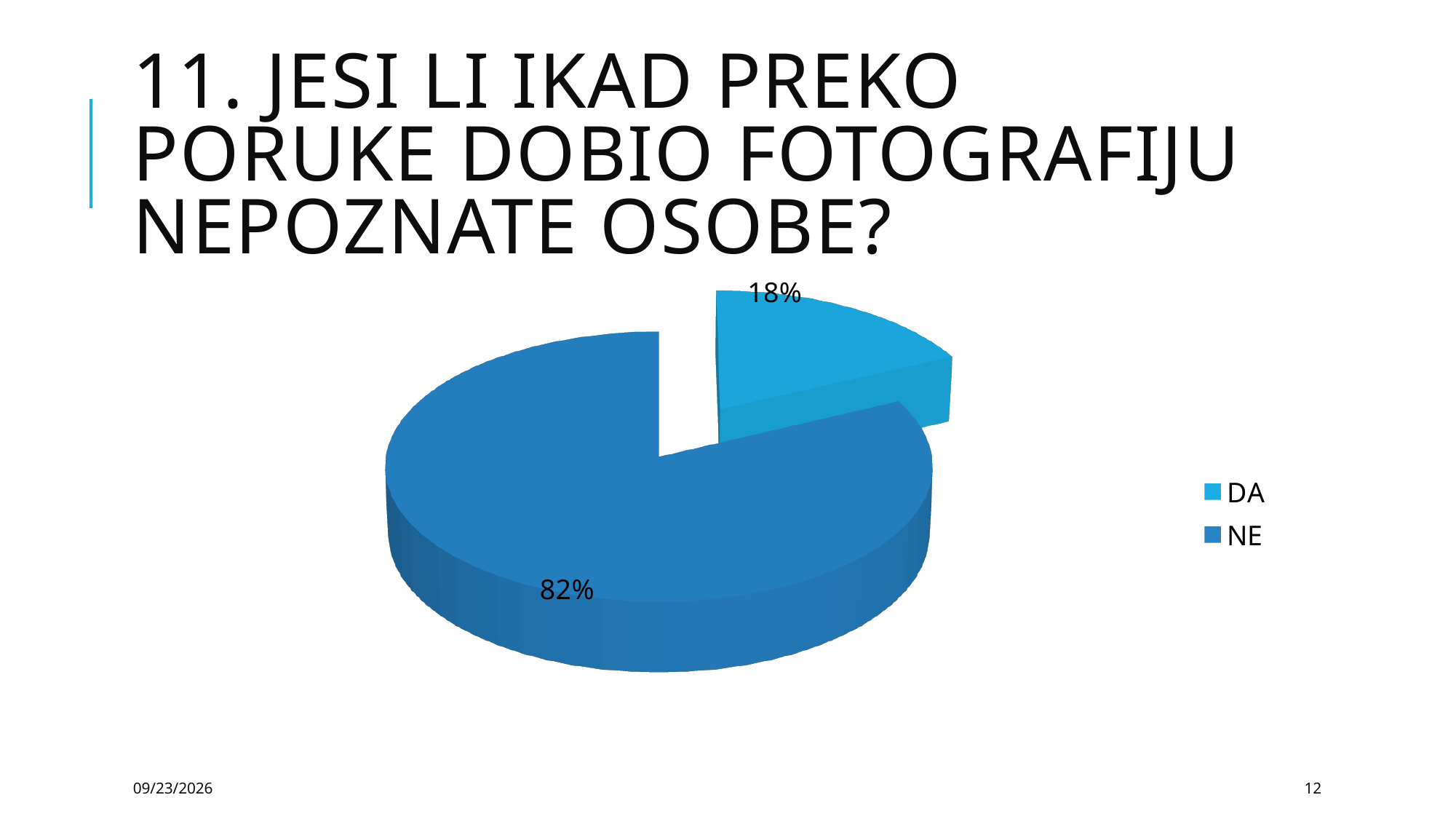
What share of the pie does the DA slice represent? 18% How many slices does the pie chart have? 2 What kind of chart is shown on the slide? pie chart Which slice is larger, DA or NE? NE Which answer has the smallest share of the pie? DA Is the share for NE greater or less than 50%? greater What is the difference in percentage points between the NE and DA slices? 64 What percentage of respondents answered NE? 82% Which legend entry is shown in the lighter blue colour? DA Which answer has the largest share of the pie? NE What percentage of respondents answered DA? 18% How many entries does the legend list? 2